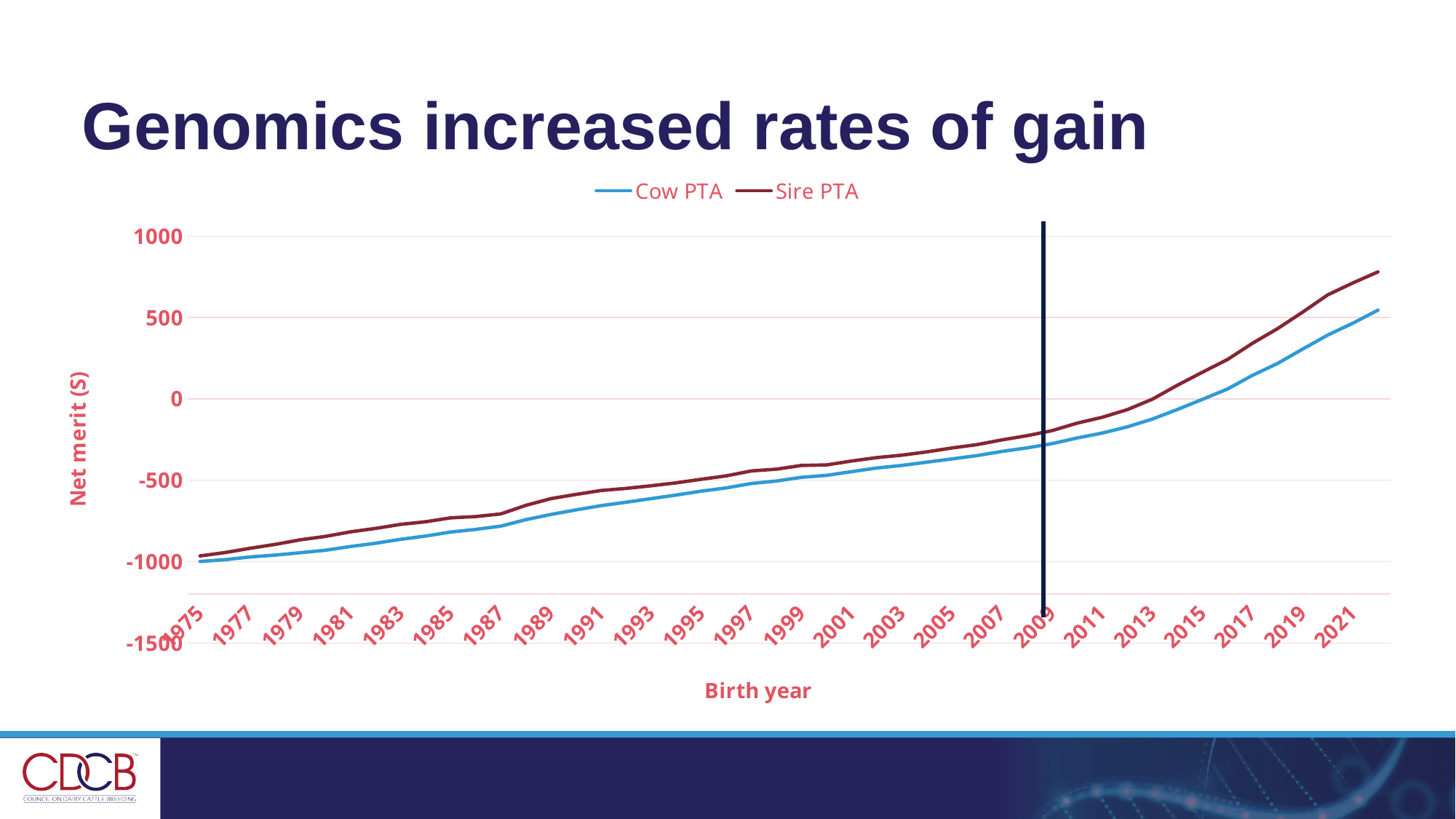
Is the Cow PTA value for 1975 greater or less than -500? less Is the Sire PTA value for 2009 greater or less than 0? less What kind of chart is shown on the slide? line chart Is the Sire PTA value for 2015 greater or less than 0? greater Do the Sire PTA values rise or fall from 1975 to 2021? rise At which birth year is the vertical line drawn on the chart? 2009 What is the label on the vertical axis of the chart? Net merit ($) Which series is higher in 2021, Cow PTA or Sire PTA? Sire PTA How many series does the legend list? 2